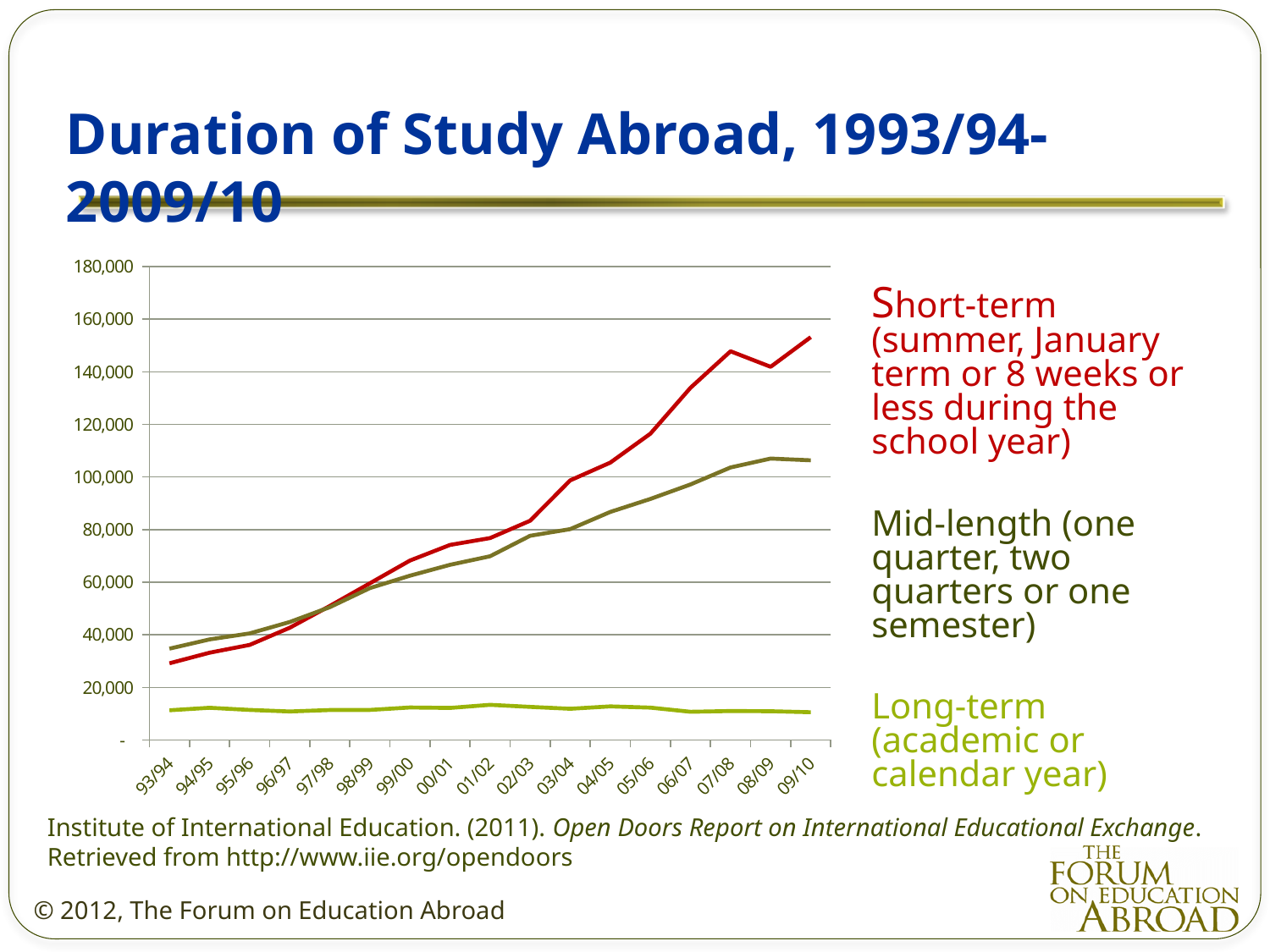
Does the Short-term series generally rise or fall from 93/94 to 09/10? Rise What is the title of the chart on the slide? Duration of Study Abroad, 1993/94-2009/10 Is the Mid-length value for 01/02 greater or less than 60,000? greater How many series (duration categories) are plotted on the chart? 3 Which series has the highest value in 09/10? Short-term How many academic years are plotted along the x axis? 17 In 93/94, which is larger: the Short-term value or the Mid-length value? Mid-length Is the Long-term value for 09/10 greater or less than 20,000? less What kind of chart is shown on the slide? Line chart Which series has the lowest values across the whole period? Long-term Is the Short-term value for 93/94 greater or less than 40,000? less